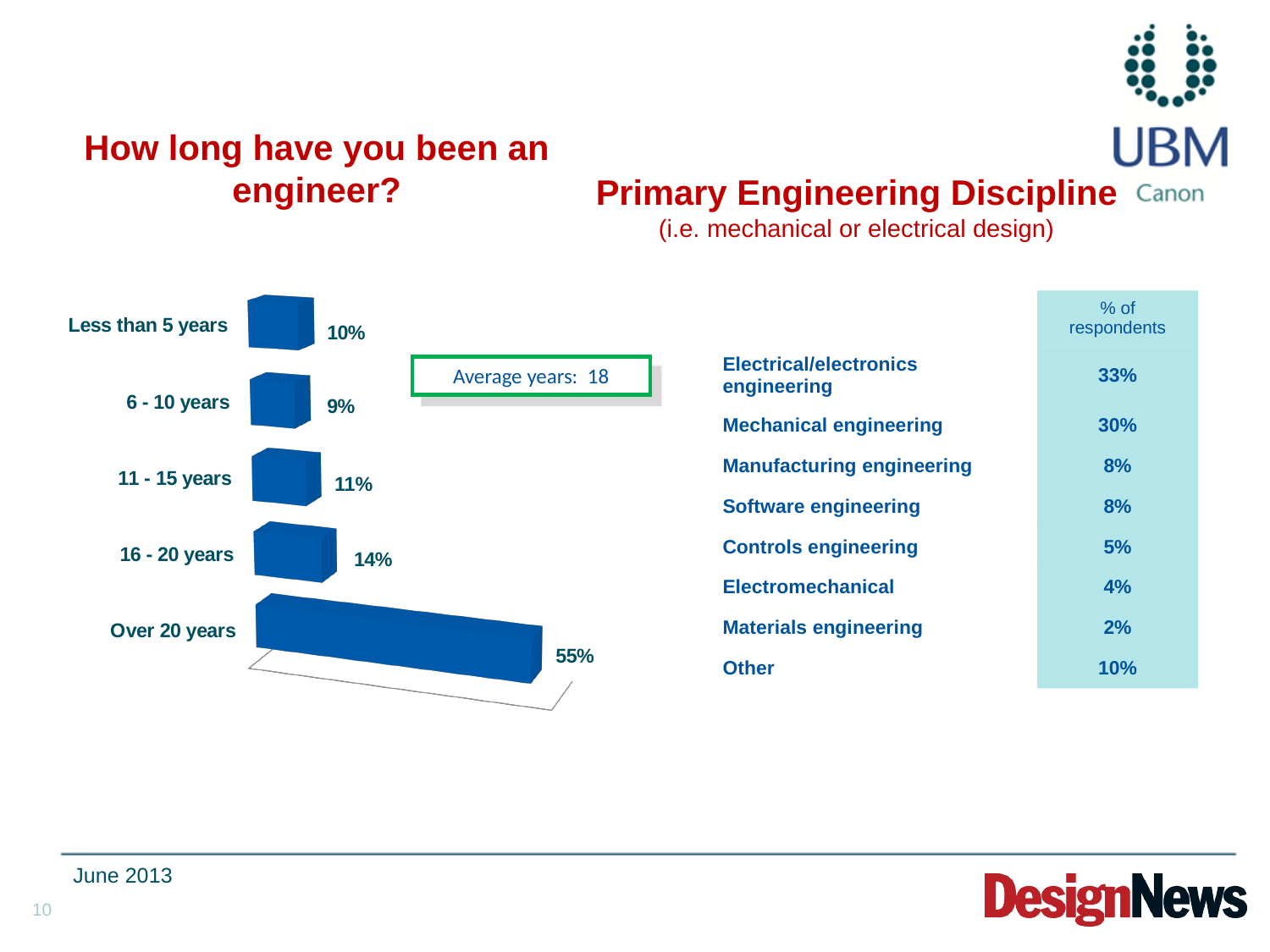
What type of chart is used for 'How long have you been an engineer?'? Bar chart How many categories are shown in the 'How long have you been an engineer?' chart? 5 In the 'How long have you been an engineer?' chart, what is the value for 'Less than 5 years'? 10% In the 'How long have you been an engineer?' chart, what is the value for '16 - 20 years'? 14% In the 'How long have you been an engineer?' chart, what percentage of respondents have been engineers for over 20 years? 55% In the 'How long have you been an engineer?' chart, which is larger: the value for '11 - 15 years' or the value for 'Less than 5 years'? 11 - 15 years In the 'How long have you been an engineer?' chart, which category has the lowest value? 6 - 10 years What colour are the bars in the 'How long have you been an engineer?' chart? Blue In the 'How long have you been an engineer?' chart, what is the value for '6 - 10 years'? 9% What average number of years is shown in the box on the 'How long have you been an engineer?' chart? 18 In the 'How long have you been an engineer?' chart, which category has the highest value? Over 20 years In the 'How long have you been an engineer?' chart, what is the difference between the 'Over 20 years' value and the '16 - 20 years' value? 41%